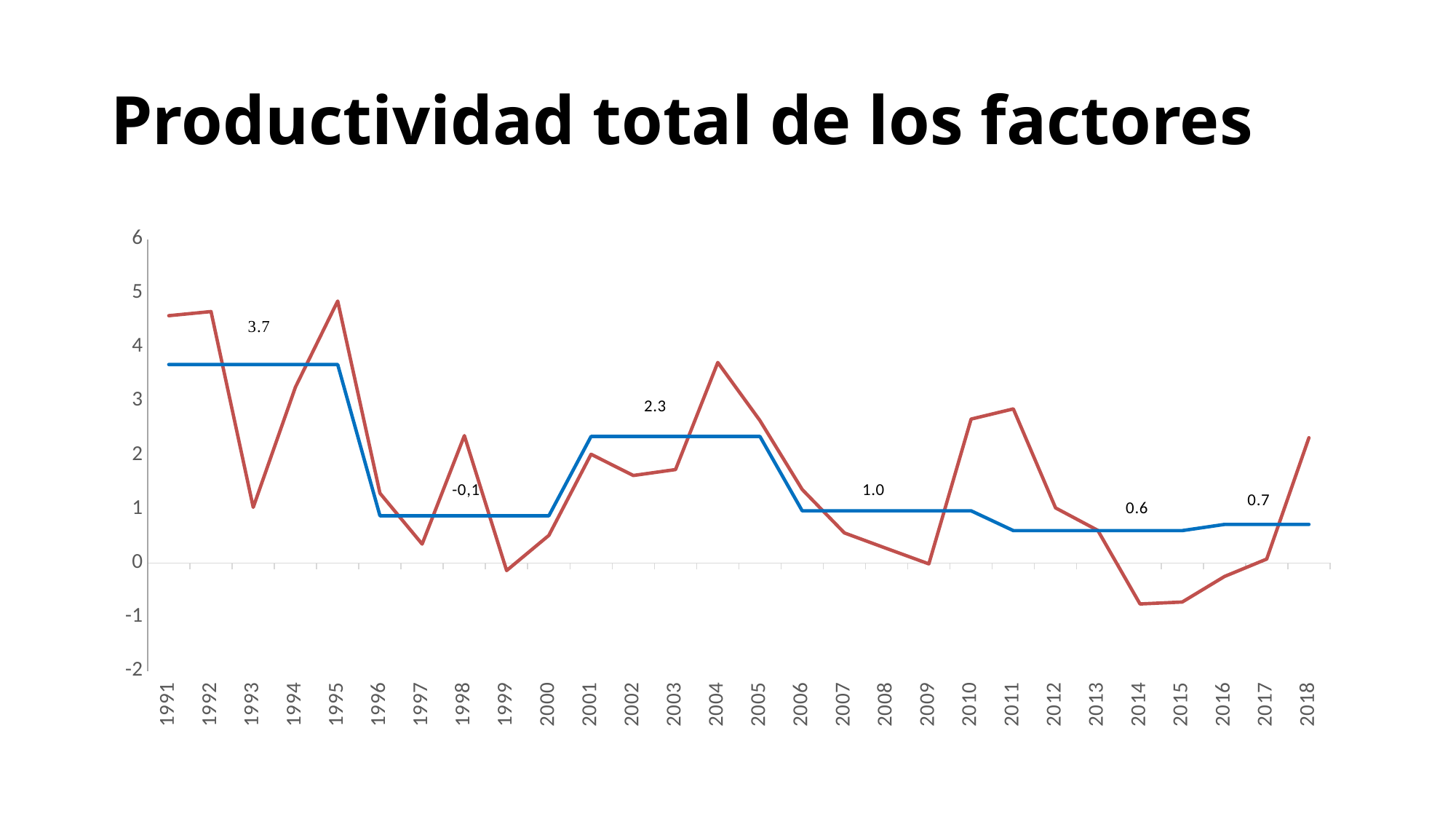
What value is labelled on the blue line for the 2016–2018 period? 0.7 Is the red line value for 1999 greater or less than 0? less What value is labelled on the blue line for the 2001–2005 period? 2.3 What is the difference between the labelled blue-line values 3.7 and 2.3? 1.4 What is the title of the chart? Productividad total de los factores Is the red line value for 2004 greater or less than 3? greater How many years are shown along the x axis? 28 What value is labelled on the blue line for the 1991–1995 period? 3.7 In which year does the red line reach its highest value? 1995 What kind of chart is shown on the slide? line chart What value is labelled on the blue line for the 2006–2009 period? 1.0 Which is larger on the red line, the value for 2004 or the value for 2010? 2004